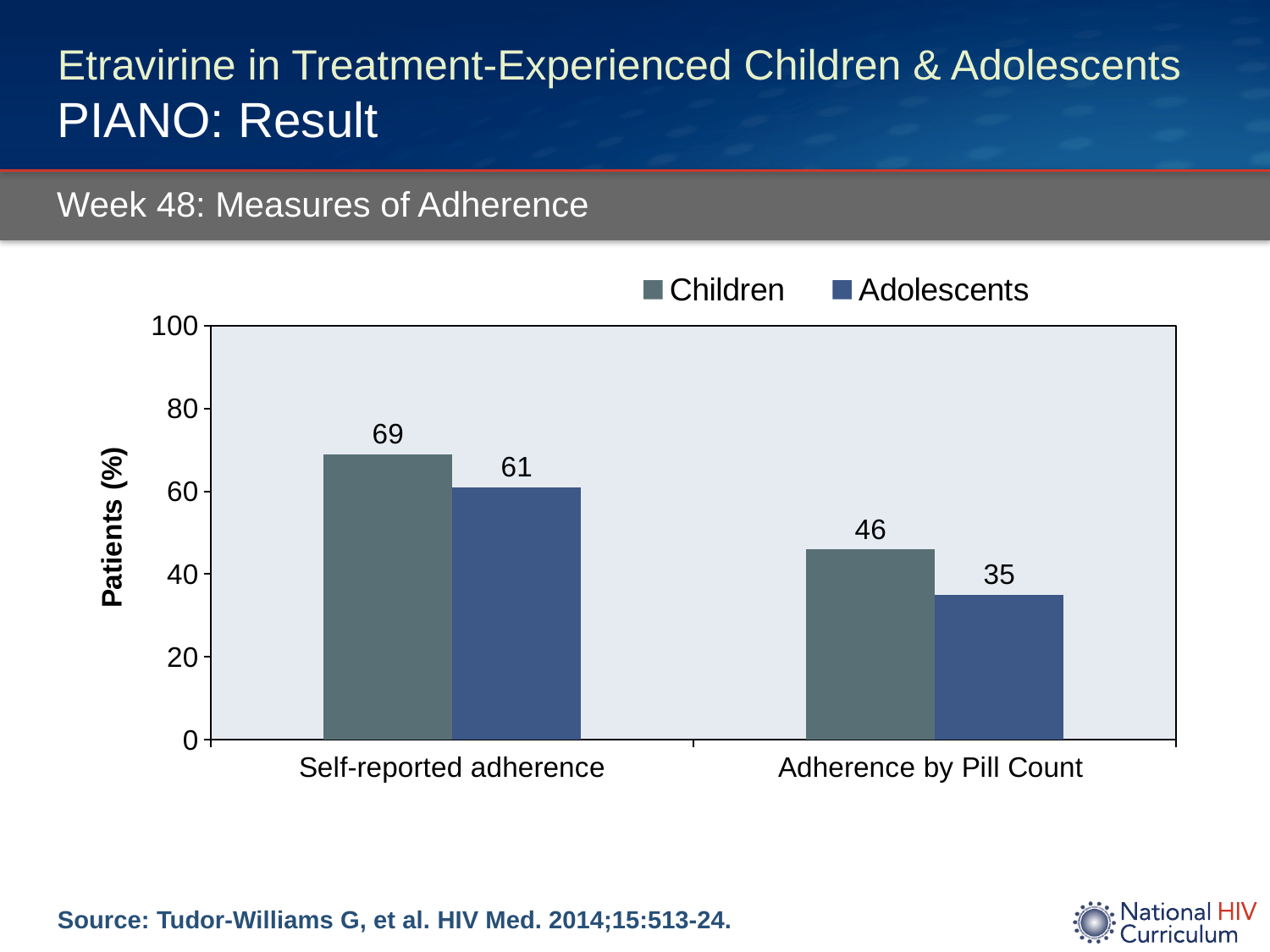
What is the value for Children for Self-reported adherence? 69 Which bar has the highest value on the chart? Children, Self-reported adherence How many categories are shown on the x axis? 2 What kind of chart is shown on the slide? Bar chart What is the value for Children for Adherence by Pill Count? 46 What is the value for Adolescents for Adherence by Pill Count? 35 How many series does the legend list? 2 Which is larger: the Children value for Adherence by Pill Count or the Adolescents value for Self-reported adherence? Adolescents value for Self-reported adherence What is the difference between the Children and Adolescents values for Self-reported adherence? 8 Which bar has the lowest value on the chart? Adolescents, Adherence by Pill Count What is the difference between the Children and Adolescents values for Adherence by Pill Count? 11 What is the value for Adolescents for Self-reported adherence? 61